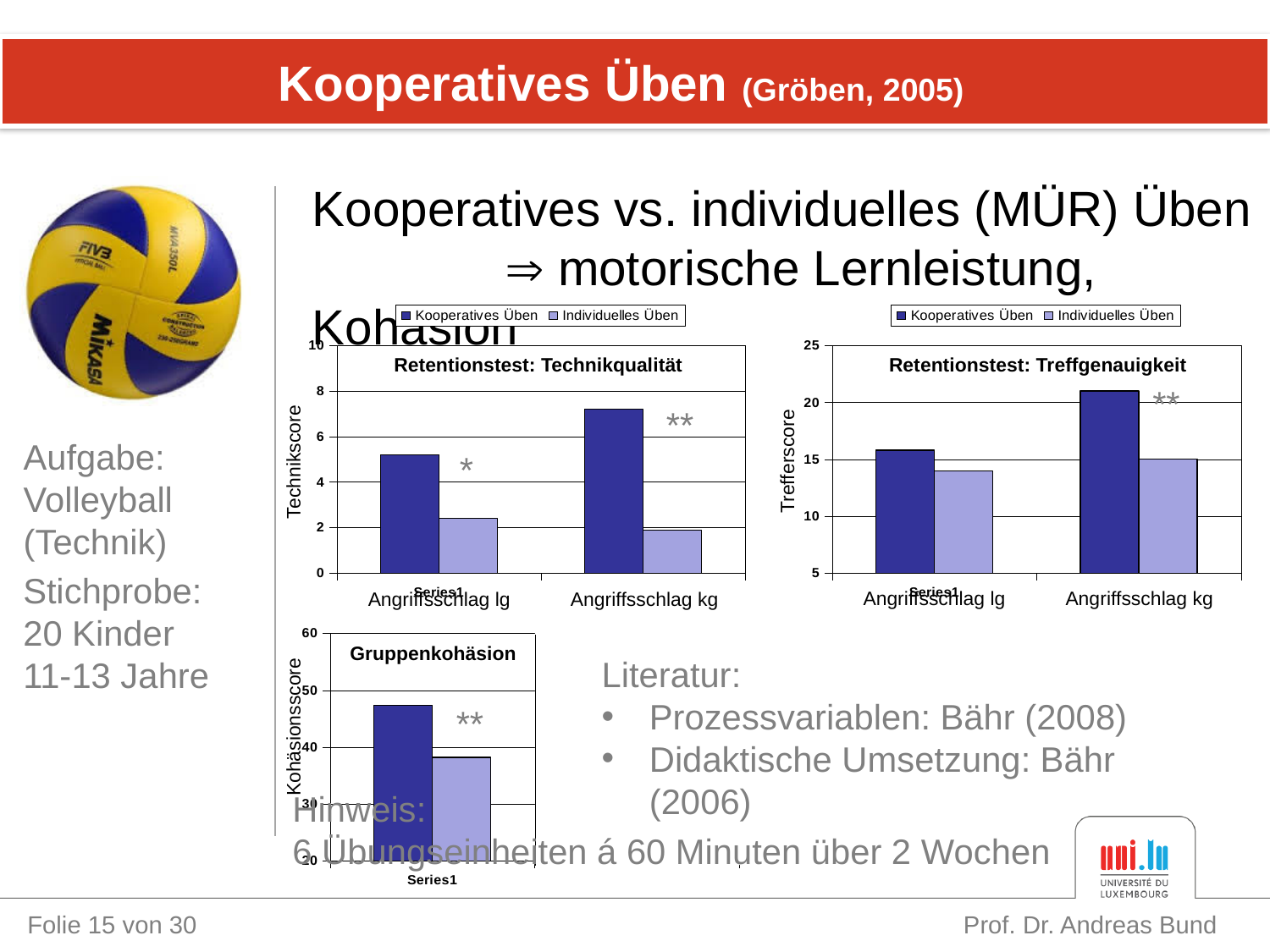
In the "Gruppenkohäsion" chart, is the Individuelles Üben value greater or less than 40? less In the "Retentionstest: Technikqualität" chart, is the Kooperatives Üben value for Angriffsschlag kg greater or less than 6? greater In the "Retentionstest: Treffgenauigkeit" chart, is the Kooperatives Üben value for Angriffsschlag kg greater or less than 20? greater In the "Retentionstest: Technikqualität" chart, how many categories are shown on the x axis? 2 In the "Gruppenkohäsion" chart, which series has the larger value, Kooperatives Üben or Individuelles Üben? Kooperatives Üben What kind of chart is the "Retentionstest: Technikqualität" chart? bar chart What is the y-axis label of the "Retentionstest: Treffgenauigkeit" chart? Trefferscore In the "Retentionstest: Technikqualität" chart, which series has the larger value for Angriffsschlag kg, Kooperatives Üben or Individuelles Üben? Kooperatives Üben In the "Retentionstest: Treffgenauigkeit" chart, which bar is the highest? Kooperatives Üben, Angriffsschlag kg In the "Retentionstest: Technikqualität" chart, which bar is the lowest? Individuelles Üben, Angriffsschlag kg How many series does the legend of the "Retentionstest: Treffgenauigkeit" chart list? 2